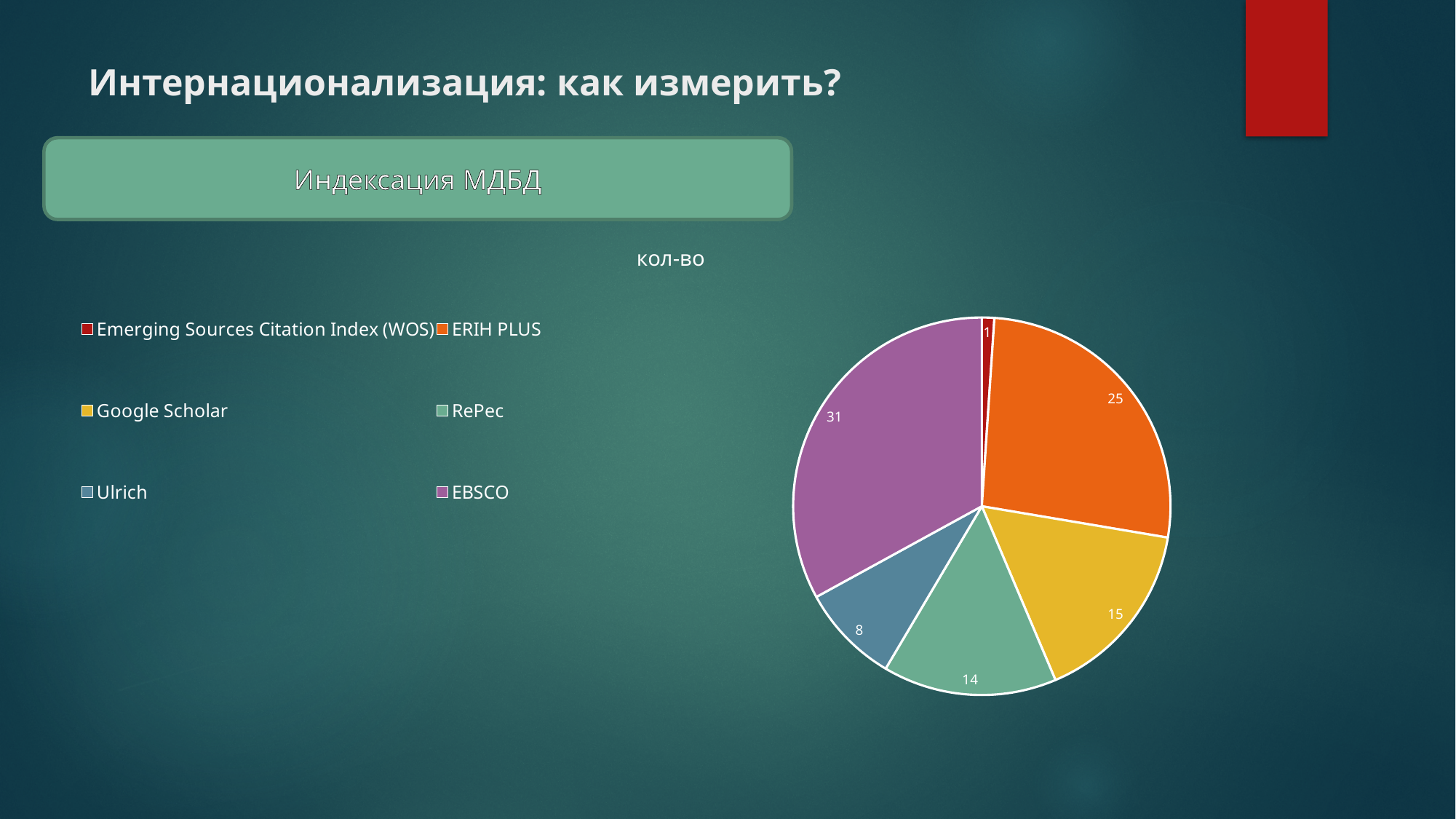
What kind of chart is shown on the slide? Pie chart Which category has the smallest slice in the pie chart? Emerging Sources Citation Index (WOS) What is the value for Ulrich in the pie chart? 8 What is the value for RePec in the pie chart? 14 Which is larger, the value for Ulrich or the value for RePec? RePec What is the title of the chart? кол-во Which category has the largest slice in the pie chart? EBSCO How many categories does the pie chart show? 6 What is the difference between the values for EBSCO and ERIH PLUS? 6 What is the value for ERIH PLUS in the pie chart? 25 What is the value for Google Scholar in the pie chart? 15 What is the value for EBSCO in the pie chart? 31